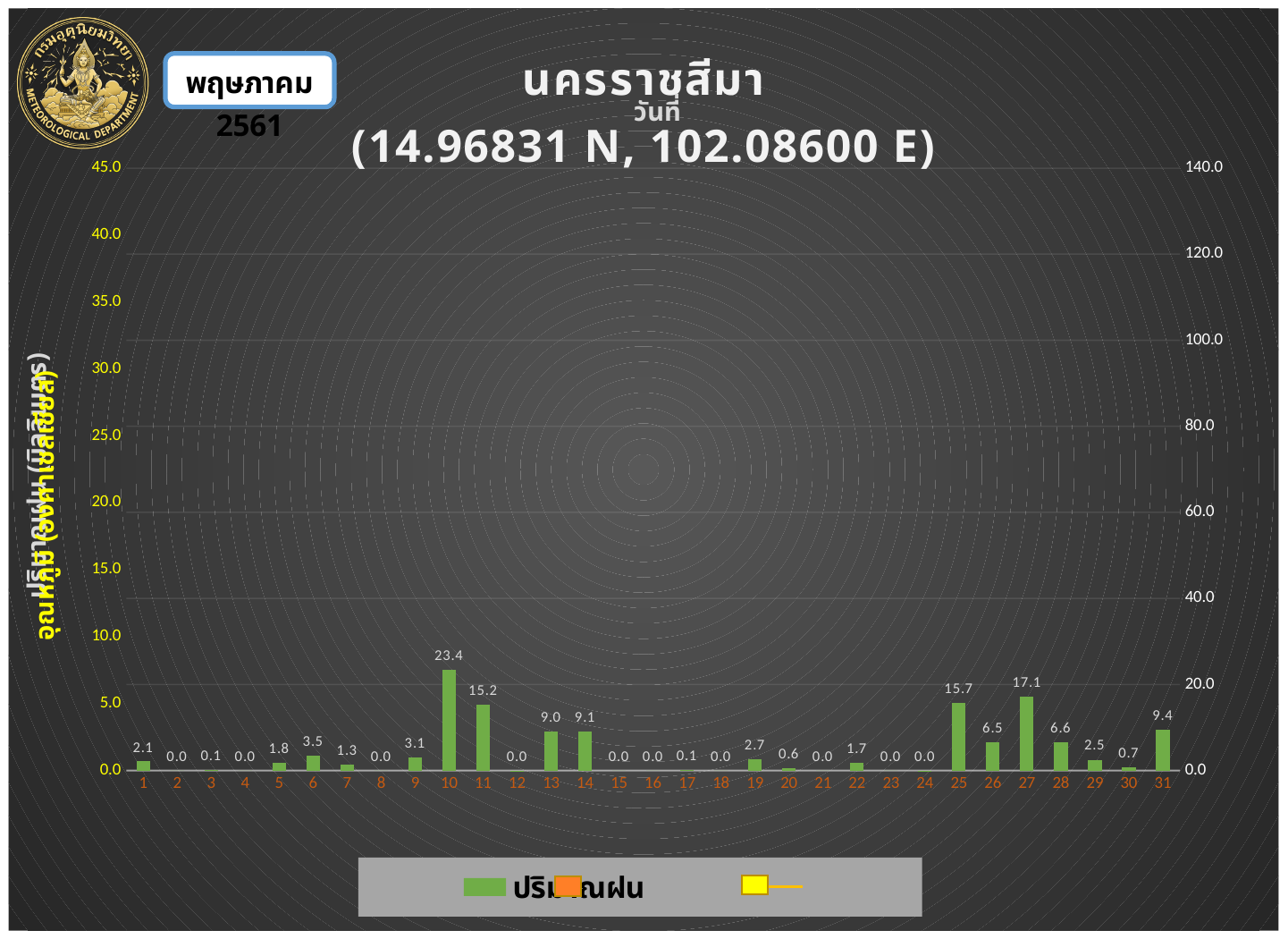
What is the value shown for day 31? 9.4 What kind of chart is shown on the slide? bar chart Which is larger, the value for day 10 or the value for day 27? day 10 What is the rainfall value shown for day 10? 23.4 What is the station name given in the chart title? นครราชสีมา What is the value shown for day 6? 3.5 What is the difference between the values for day 10 and day 11? 8.2 Is the value for day 10 greater or less than 20.0? greater How many days are shown on the x axis of the chart? 31 What is the value shown for day 27? 17.1 What is the difference between the values for day 27 and day 25? 1.4 Which day has the highest value in the chart? 10